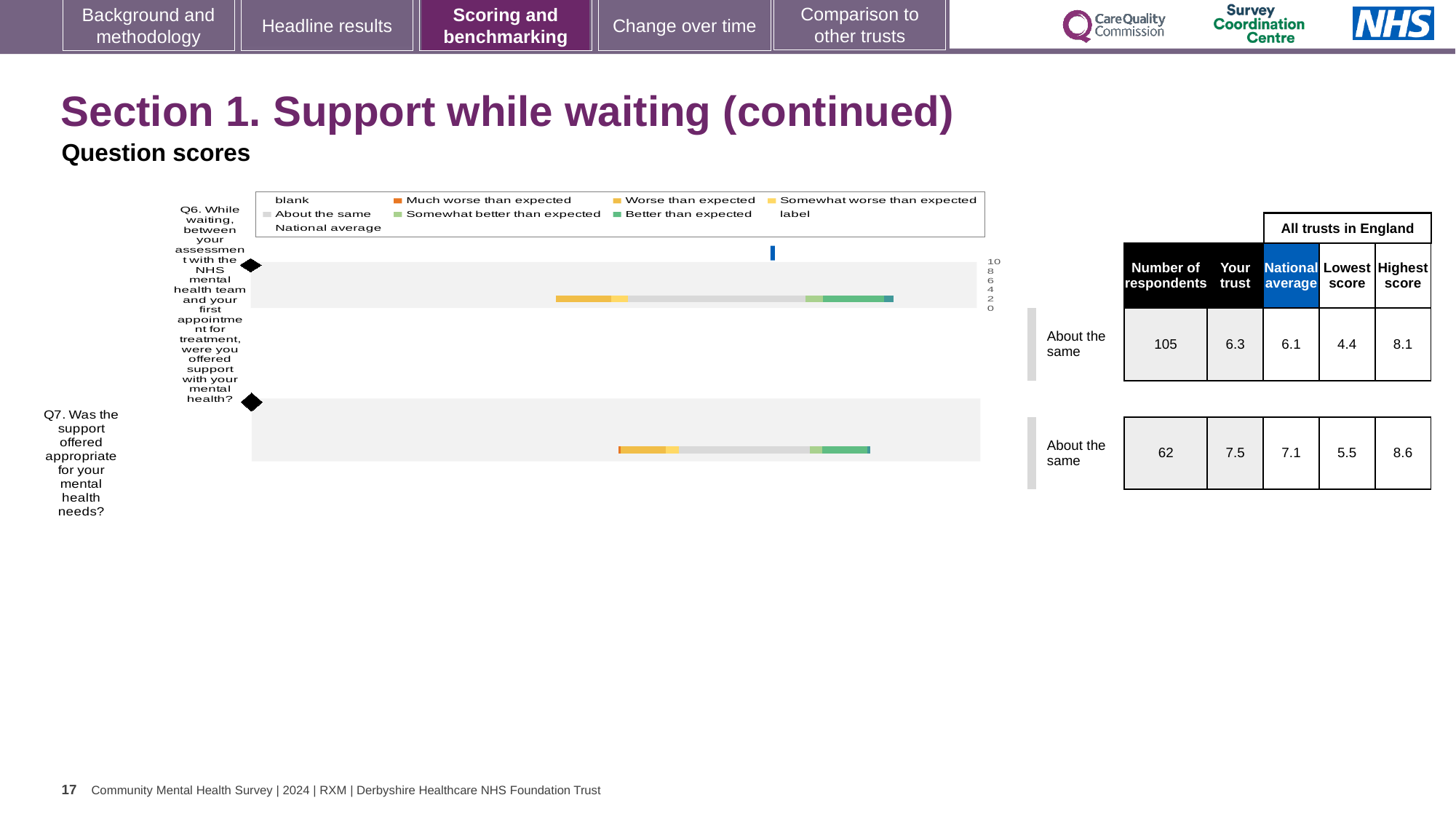
Which legend entry is shown in dark green? Better than expected What benchmark category is given for Q7 next to the chart? About the same According to the table beside the chart, how many respondents answered Q6? 105 Which legend entry is shown in orange? Much worse than expected What kind of chart is shown on the slide? bar chart Which question has the higher 'Your trust' score in the table beside the chart, Q6 or Q7? Q7 According to the table beside the chart, what is the national average for Q7? 7.1 How many entries does the chart legend list? 9 How many survey questions (bars) are plotted in the chart? 2 According to the table beside the chart, what is the highest score among all trusts in England for Q6? 8.1 According to the table beside the chart, what is the 'Your trust' score for Q6? 6.3 According to the table beside the chart, what is the 'Your trust' score for Q7? 7.5